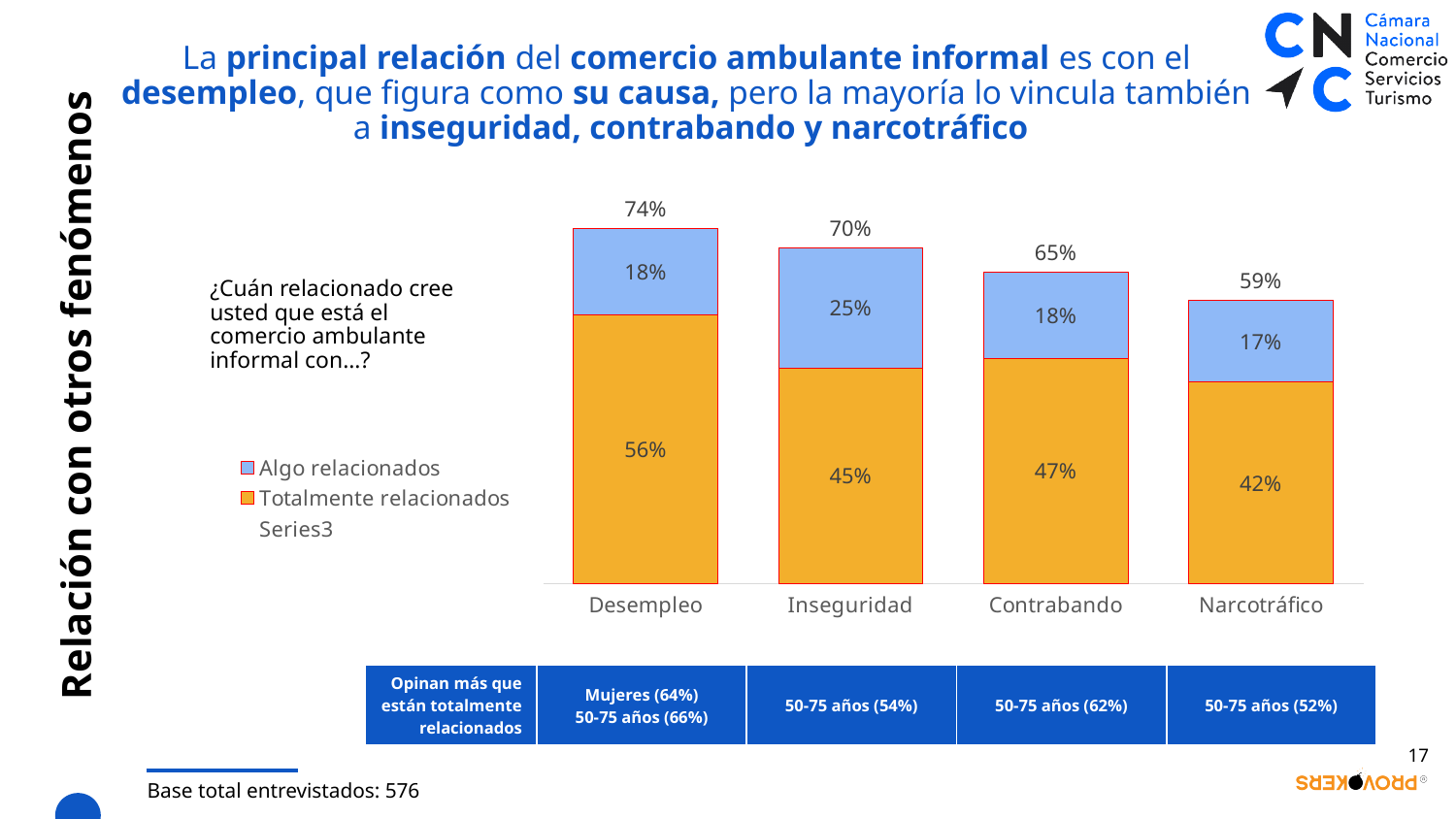
How many entries does the legend list? 3 What is the 'Totalmente relacionados' value for Narcotráfico? 42% Which category has the highest total? Desempleo Which is larger: the 'Algo relacionados' value for Inseguridad or for Contrabando? Inseguridad What is the total shown above the Contrabando bar? 65% What is the 'Algo relacionados' value for Inseguridad? 25% What type of chart is shown on the slide? Stacked bar chart What is the difference between the 'Totalmente relacionados' values for Desempleo and Inseguridad? 11% What is the 'Totalmente relacionados' value for Desempleo? 56% Which category has the lowest 'Totalmente relacionados' value? Narcotráfico How many categories are shown on the x axis? 4 Do the bar totals rise or fall from Desempleo to Narcotráfico? Fall